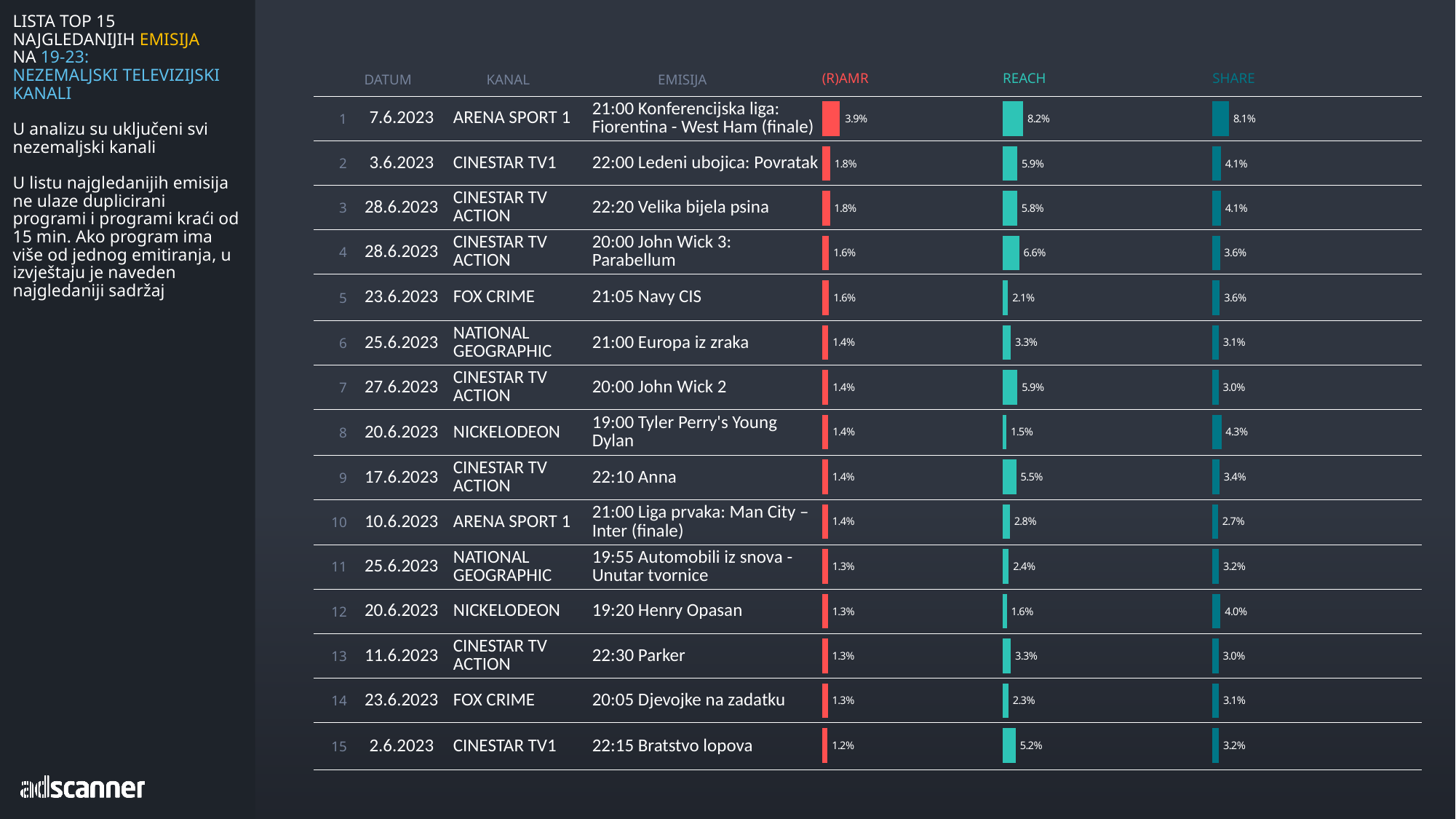
In the REACH column, which programme has the highest value? 21:00 Konferencijska liga: Fiorentina - West Ham (finale) What colour are the bars in the (R)AMR column? Red What kind of chart is used in the (R)AMR, REACH and SHARE columns? Bar chart In the REACH column, which programme has the lowest value? 19:00 Tyler Perry's Young Dylan How many programmes are listed in the table? 15 In the (R)AMR column, which programme has the lowest value? 22:15 Bratstvo lopova In the (R)AMR column, what is the value for the programme ranked 1, 21:00 Konferencijska liga: Fiorentina - West Ham (finale)? 3.9% In the SHARE column, what is the difference between the value for 21:00 Konferencijska liga: Fiorentina - West Ham (finale) and the value for 22:00 Ledeni ubojica: Povratak? 4.0% In the (R)AMR column, what is the difference between the value for 21:00 Konferencijska liga: Fiorentina - West Ham (finale) and the value for 22:15 Bratstvo lopova? 2.7% In the REACH column, which is larger: the value for 21:05 Navy CIS or the value for 22:10 Anna? 22:10 Anna In the REACH column, what is the value for 20:00 John Wick 3: Parabellum? 6.6% In the SHARE column, what is the value for 19:00 Tyler Perry's Young Dylan? 4.3%